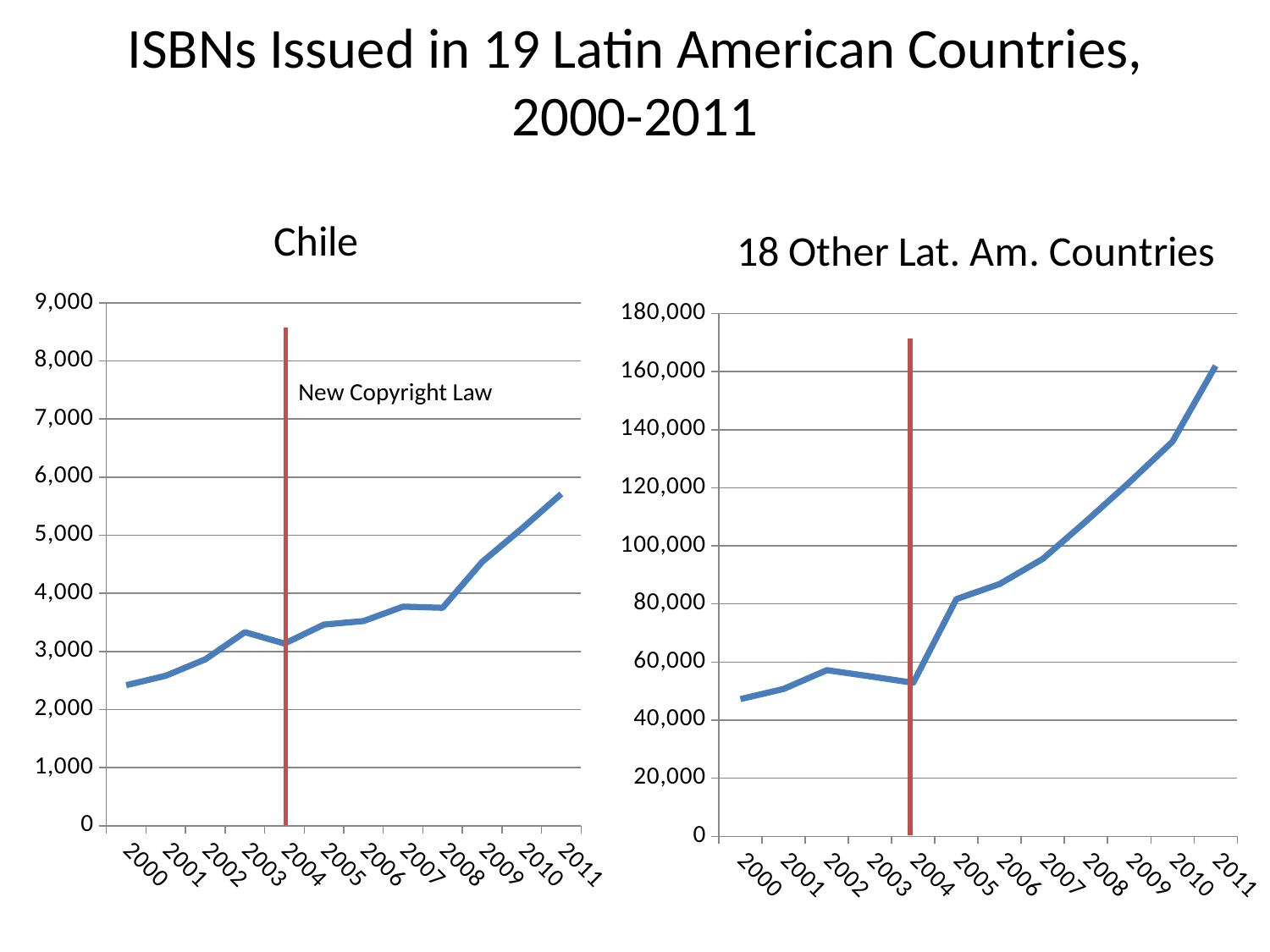
In the 18 Other Lat. Am. Countries chart, which year has the lowest value? 2000 In the 18 Other Lat. Am. Countries chart, which year has the highest value? 2011 How many years are plotted on the x axis of the Chile chart? 12 In the Chile chart, is the value for 2000 greater or less than 3,000? less In the Chile chart, which year has the highest number of ISBNs issued? 2011 In the Chile chart, is the value for 2011 greater or less than 5,000? greater What event does the vertical red line in the Chile chart mark? New Copyright Law What kind of chart is the Chile chart? line chart In the Chile chart, which year has the lowest number of ISBNs issued? 2000 In the 18 Other Lat. Am. Countries chart, is the value for 2011 greater or less than 140,000? greater In the Chile chart, which year has the larger value, 2003 or 2004? 2003 In the 18 Other Lat. Am. Countries chart, do the values generally rise or fall from 2004 to 2011? rise